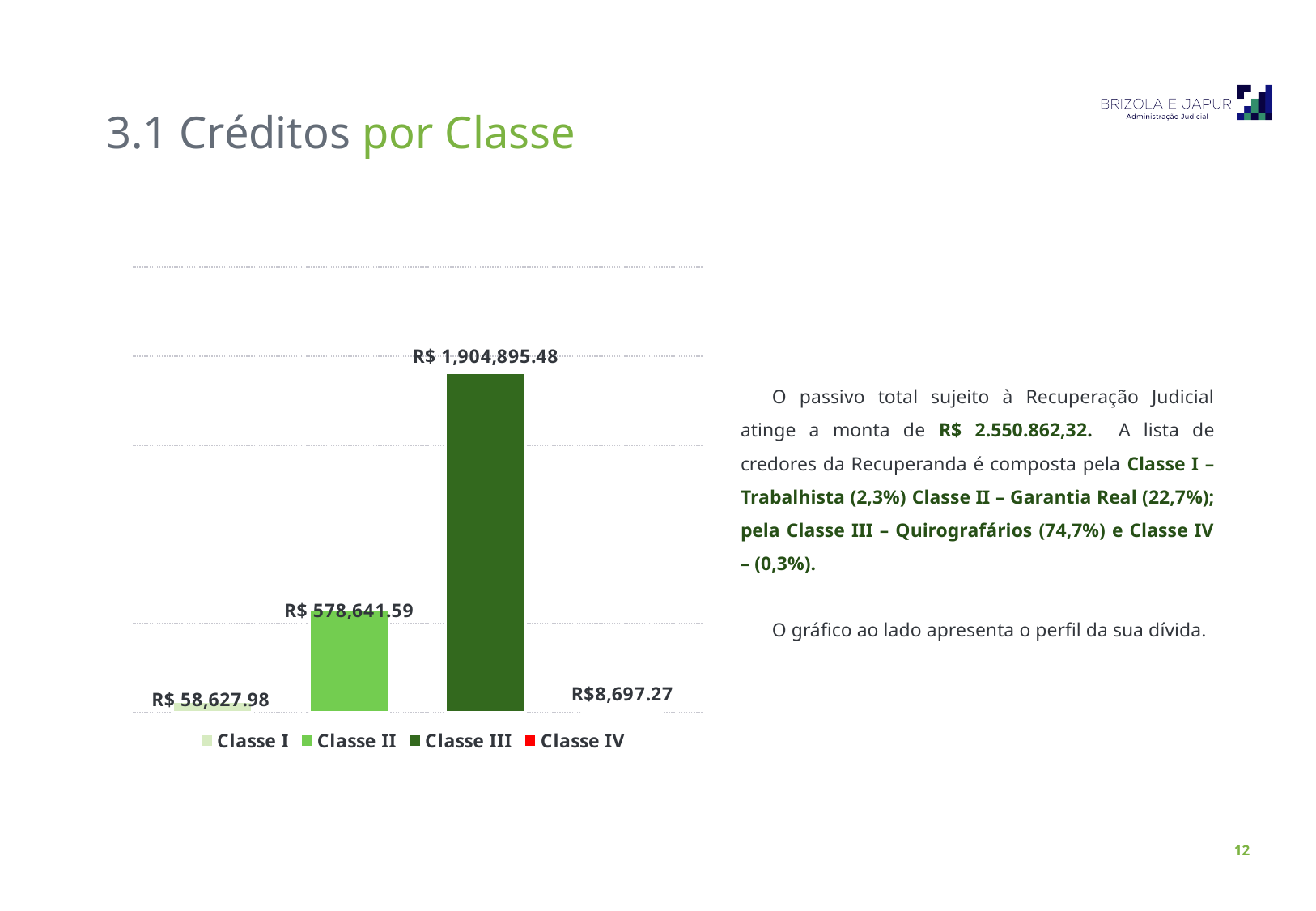
What is the value shown for Classe III? R$ 1,904,895.48 What is the value shown for Classe II? R$ 578,641.59 What is the difference between the values for Classe III and Classe II? R$ 1,326,253.89 What is the value shown for Classe IV? R$8,697.27 How many bars are plotted in the chart? 4 What is the value shown for Classe I? R$ 58,627.98 Which class has the lowest value in the chart? Classe IV How many series does the legend list? 4 What is the difference between the values for Classe II and Classe I? R$ 520,013.61 Which class has the highest value in the chart? Classe III What kind of chart is shown on the slide? Bar chart Which is larger, the value for Classe I or the value for Classe IV? Classe I